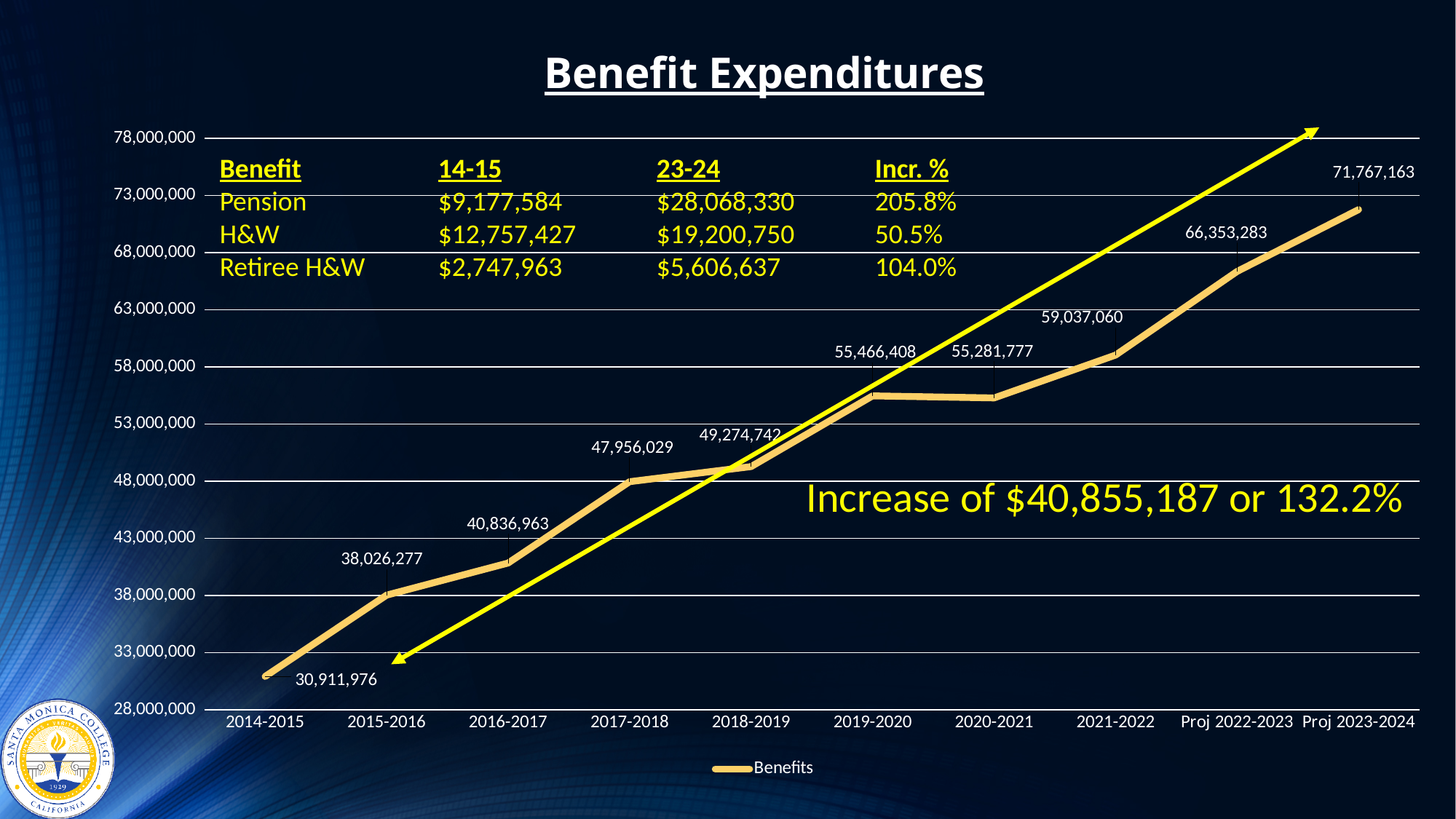
How many series does the legend list? 1 Which year has the highest Benefits value? Proj 2023-2024 What is the value of Benefits for Proj 2023-2024? 71,767,163 What is the difference between the Benefits value for Proj 2023-2024 and for 2014-2015? 40,855,187 Which is larger, the Benefits value for 2017-2018 or for 2016-2017? 2017-2018 What is the value of Benefits for 2018-2019? 49,274,742 What type of chart is shown on the slide? Line chart What is the value of Benefits for 2014-2015? 30,911,976 How many data points are plotted on the Benefits line? 10 What is the value of Benefits for 2021-2022? 59,037,060 Which year has the lowest Benefits value? 2014-2015 What is the difference between the Benefits value for 2015-2016 and for 2014-2015? 7,114,301